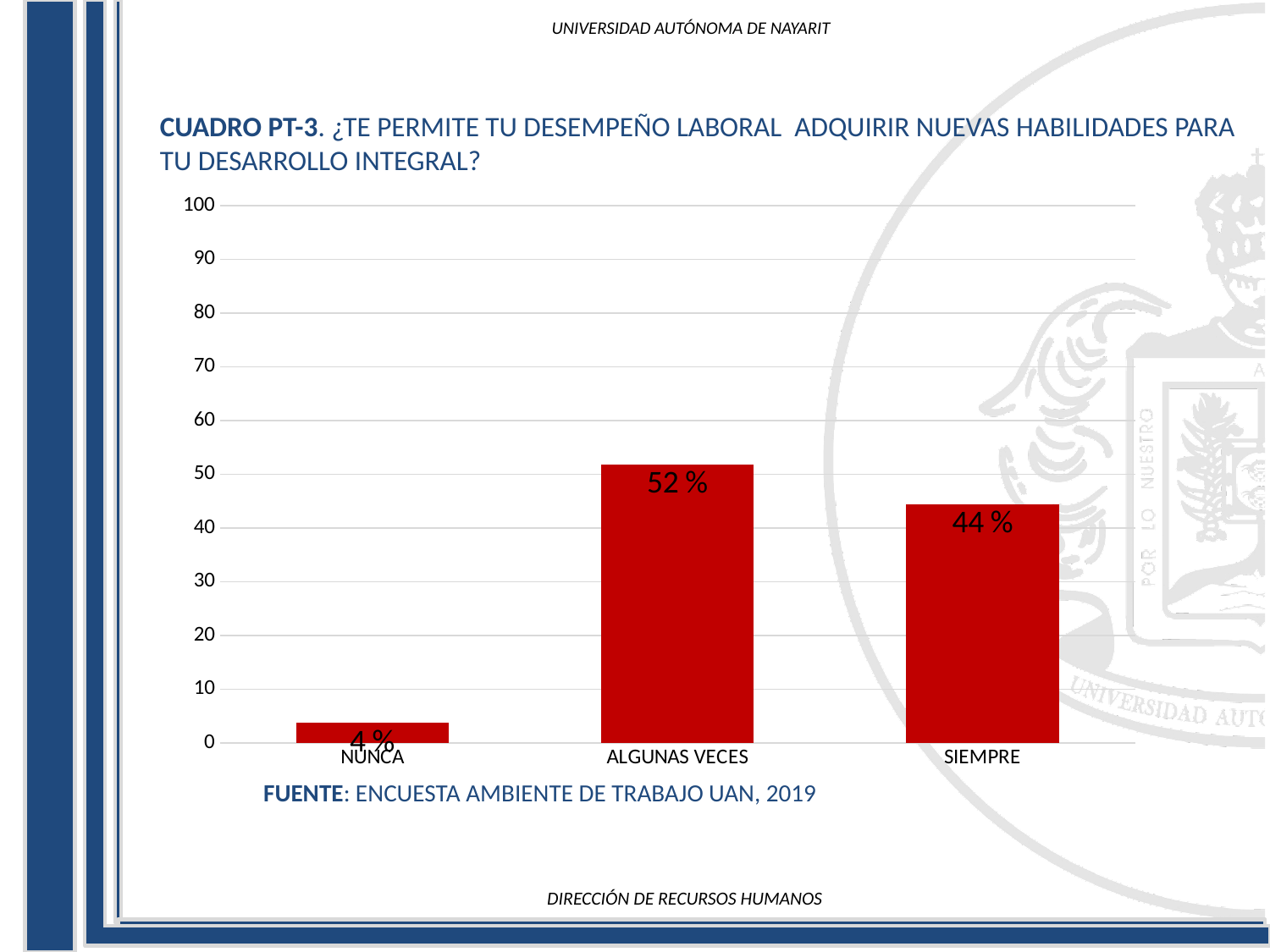
What colour are the bars in the chart? red What is the value for NUNCA? 4 % How many categories are shown on the x axis? 3 What is the source cited below the chart? ENCUESTA AMBIENTE DE TRABAJO UAN, 2019 Is the value for SIEMPRE greater or less than 50? less What is the difference between the values for ALGUNAS VECES and SIEMPRE? 8 % What kind of chart is shown on the slide? bar chart What is the value for ALGUNAS VECES? 52 % What is the value for SIEMPRE? 44 % Which category has the highest value? ALGUNAS VECES Which is larger, the value for SIEMPRE or the value for NUNCA? SIEMPRE Which category has the lowest value? NUNCA